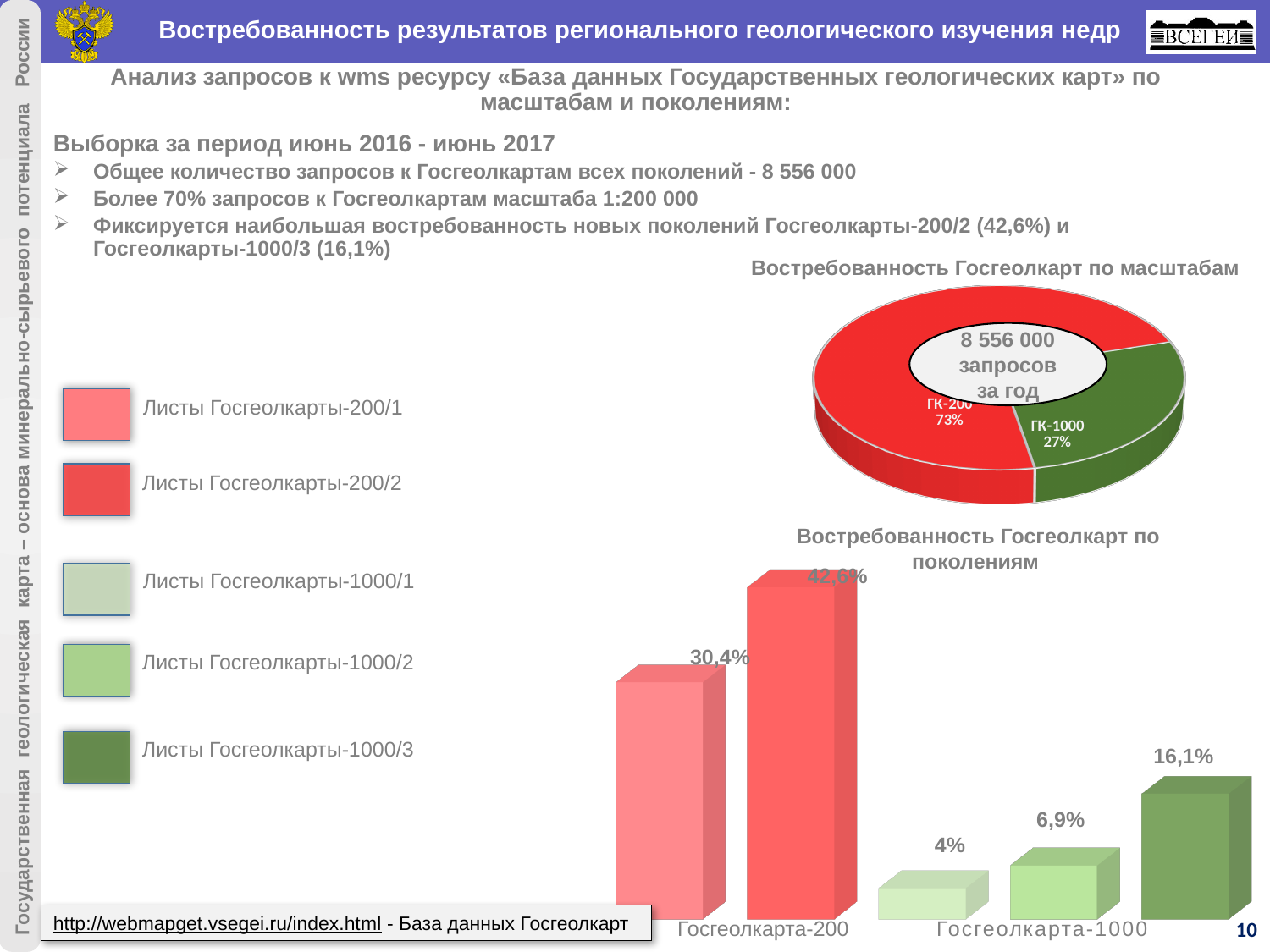
In the pie chart 'Востребованность Госгеолкарт по масштабам', what share is shown for ГК-200? 73% In the bar chart 'Востребованность Госгеолкарт по поколениям', what is the value for Листы Госгеолкарты-200/2? 42,6% In the bar chart 'Востребованность Госгеолкарт по поколениям', what is the value for Листы Госгеолкарты-1000/3? 16,1% In the pie chart 'Востребованность Госгеолкарт по масштабам', which slice is larger, ГК-200 or ГК-1000? ГК-200 In the bar chart 'Востребованность Госгеолкарт по поколениям', what is the value for Листы Госгеолкарты-200/1? 30,4% In the bar chart 'Востребованность Госгеолкарт по поколениям', how many series does the legend list? 5 What kind of chart is 'Востребованность Госгеолкарт по поколениям'? bar chart In the pie chart 'Востребованность Госгеолкарт по масштабам', how many slices are there? 2 In the bar chart 'Востребованность Госгеолкарт по поколениям', which series has the lowest value? Листы Госгеолкарты-1000/1 What total number of requests per year is printed in the centre of the pie chart 'Востребованность Госгеолкарт по масштабам'? 8 556 000 In the pie chart 'Востребованность Госгеолкарт по масштабам', what share is shown for ГК-1000? 27% In the bar chart 'Востребованность Госгеолкарт по поколениям', what is the difference between the values for Листы Госгеолкарты-200/2 and Листы Госгеолкарты-200/1? 12,2%